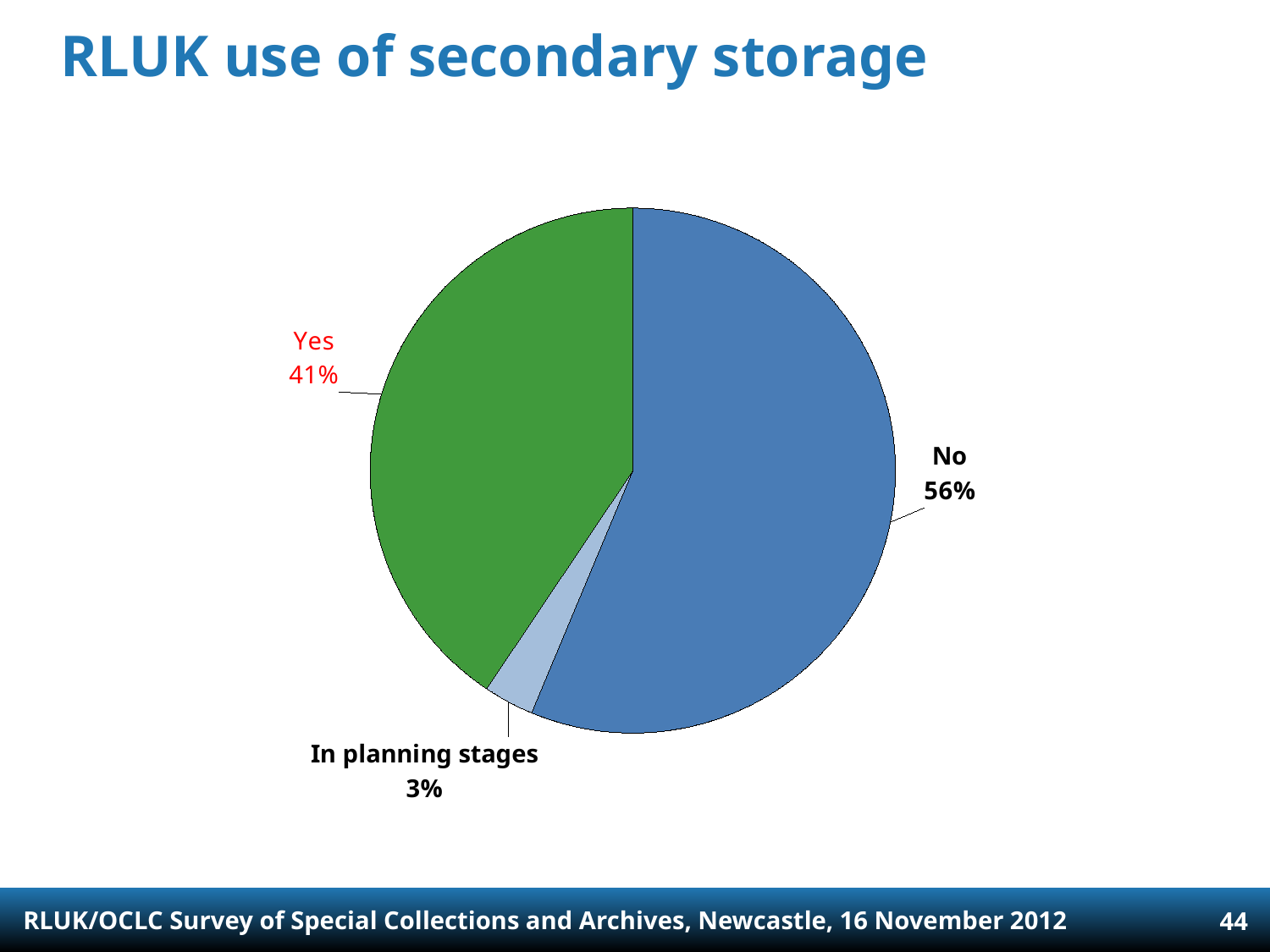
What share of the pie is labelled "No"? 56% What colour is the "Yes" slice of the pie? green What is the difference in percentage points between the "No" and "Yes" slices? 15 What share of the pie is labelled "Yes"? 41% What kind of chart is shown on the slide? pie chart Which is larger, the "Yes" slice or the "In planning stages" slice? Yes Which slice of the pie is the smallest? In planning stages What is the title of the chart on the slide? RLUK use of secondary storage How many slices does the pie chart have? 3 What share of the pie is labelled "In planning stages"? 3% Which slice of the pie is the largest? No What is the difference in percentage points between the "Yes" and "In planning stages" slices? 38